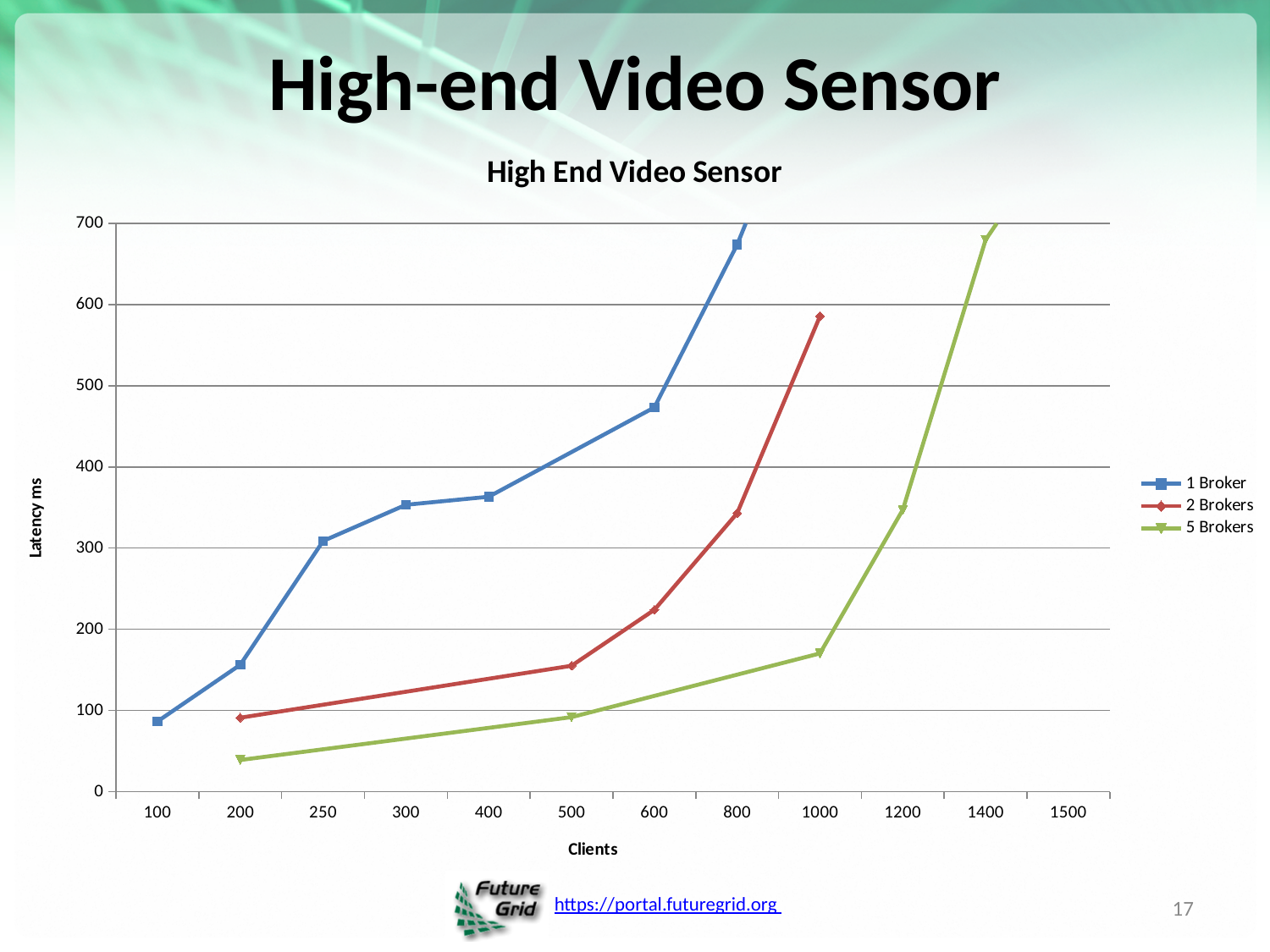
How many client values are marked along the x axis? 12 What kind of chart is shown on the slide? line chart At 600 clients, which series has the higher latency, 1 Broker or 2 Brokers? 1 Broker Is the latency for 5 Brokers at 1000 clients greater or less than 200? less How many series does the legend list? 3 At 1000 clients, which series has the higher latency, 2 Brokers or 5 Brokers? 2 Brokers Is the latency for 1 Broker at 600 clients greater or less than 500? less What is the label of the y axis? Latency ms Does the latency for 5 Brokers rise or fall as the number of clients increases? rise Is the latency for 5 Brokers at 200 clients greater or less than 100? less